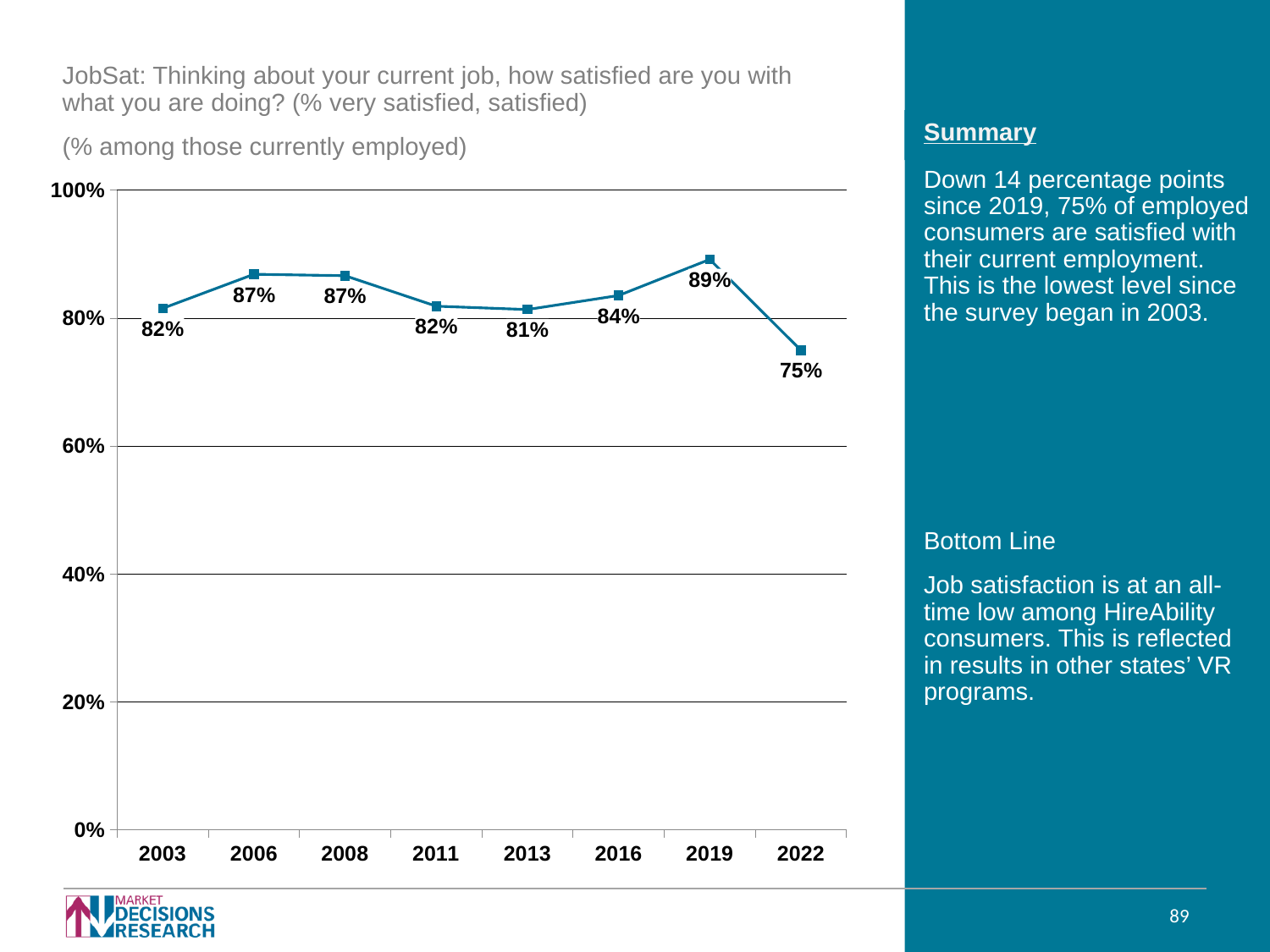
Is the value for 2022 greater or less than 80%? less How many years are plotted on the chart? 8 Which year has the lowest job satisfaction value? 2022 Which year has the larger value, 2013 or 2016? 2016 What was the job satisfaction value in 2019? 89% What is the difference between the 2006 and 2011 values? 5 percentage points What was the job satisfaction value in 2022? 75% What was the job satisfaction value in 2003? 82% Which year has the highest job satisfaction value? 2019 Did the value rise or fall between 2019 and 2022? fall What is the difference between the 2019 and 2022 values? 14 percentage points What kind of chart is shown on the slide? Line chart